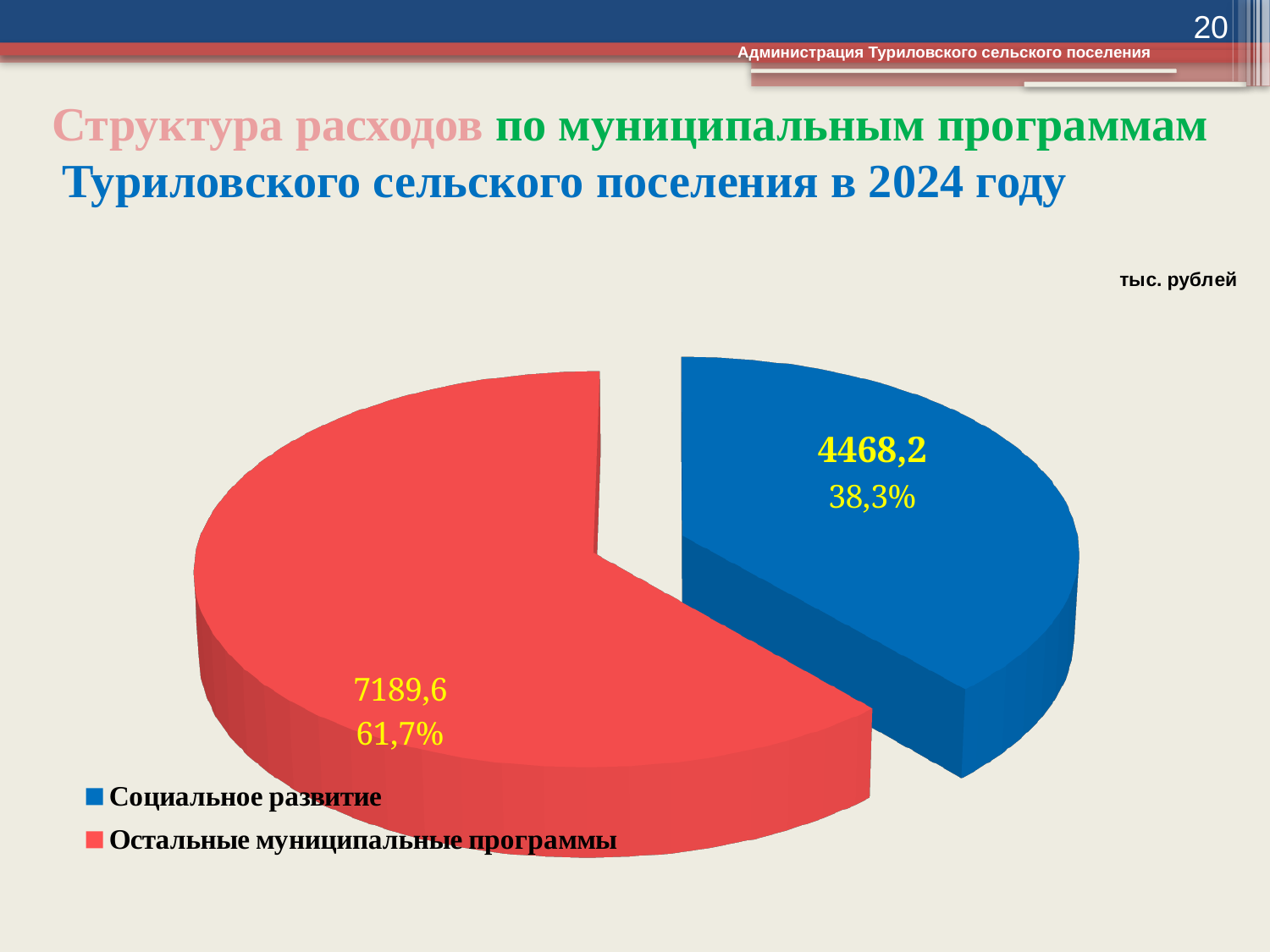
What unit of measurement is indicated for the chart? тыс. рублей How many slices does the pie chart have? 2 What share of the pie does Остальные муниципальные программы take? 61,7% Which is larger: Социальное развитие or Остальные муниципальные программы? Остальные муниципальные программы What colour is the slice for Социальное развитие? blue What is the value for Социальное развитие? 4468,2 Which category has the smallest slice of the pie? Социальное развитие What is the difference between the values for Остальные муниципальные программы and Социальное развитие? 2721,4 What share of the pie does Социальное развитие take? 38,3% Which category has the largest slice of the pie? Остальные муниципальные программы What kind of chart is shown on the slide? pie chart What is the value for Остальные муниципальные программы? 7189,6